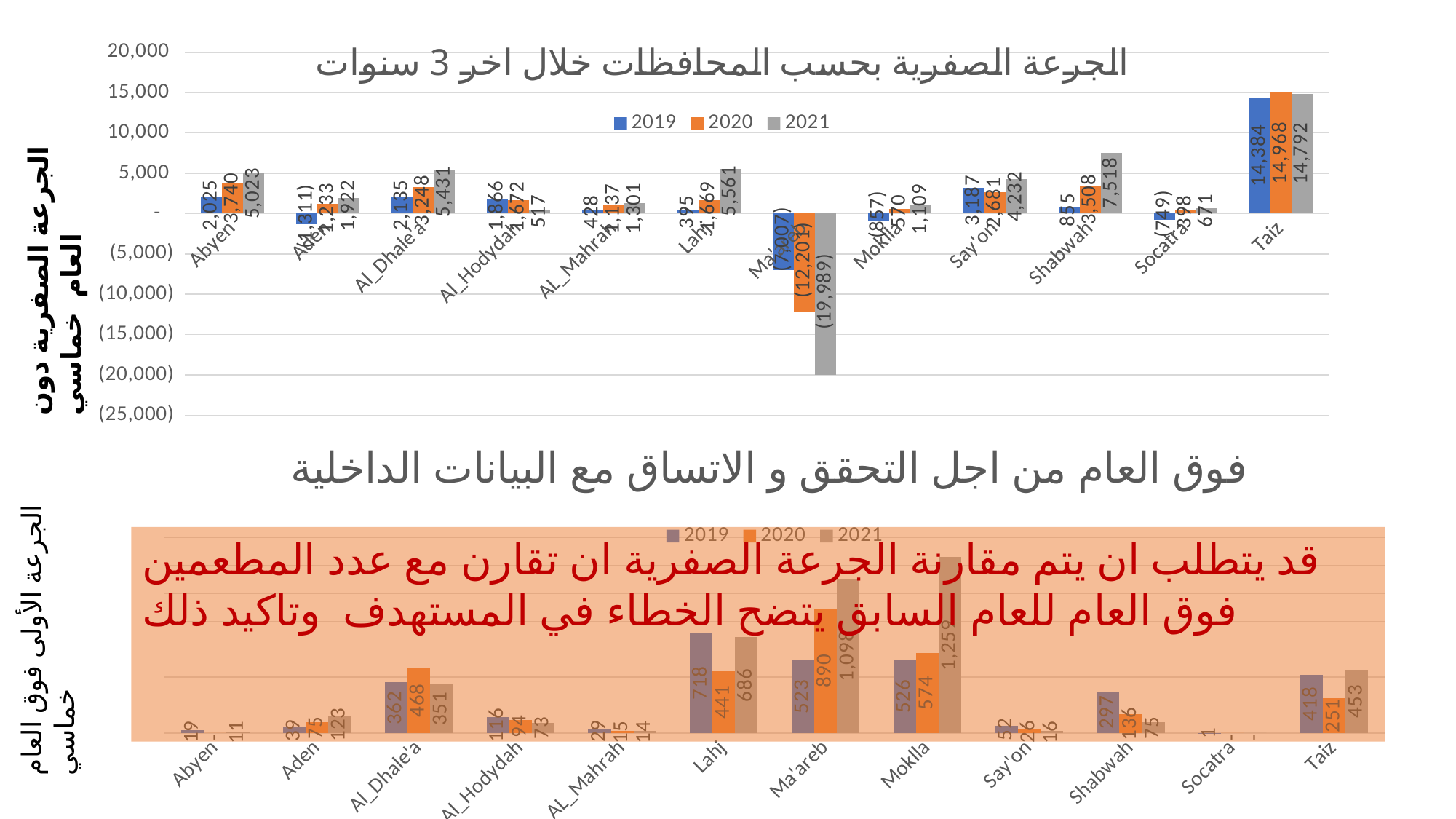
In the top chart, what is the difference between the Taiz values for 2020 and 2019? 584 In the top chart, what is the value for Ma'areb in 2021? (19,989) In the top chart, which governorate has the lowest value for 2021? Ma'areb In the bottom chart, do the values for AL_Hodydah rise or fall from 2019 to 2021? Fall In the bottom chart, what is the value for Ma'areb in 2021? 1,098 In the top chart, which governorate has the highest value for 2021? Taiz In the bottom chart, which is larger for Al_Dhale'a, the 2019 value or the 2020 value? 2020 What kind of chart is the top chart? Bar chart How many governorates are shown on the x axis of the top chart? 12 In the top chart, what is the value for Shabwah in 2021? 7,518 In the top chart, what is the value for Taiz in 2020? 14,968 How many series does the legend of the top chart list? 3